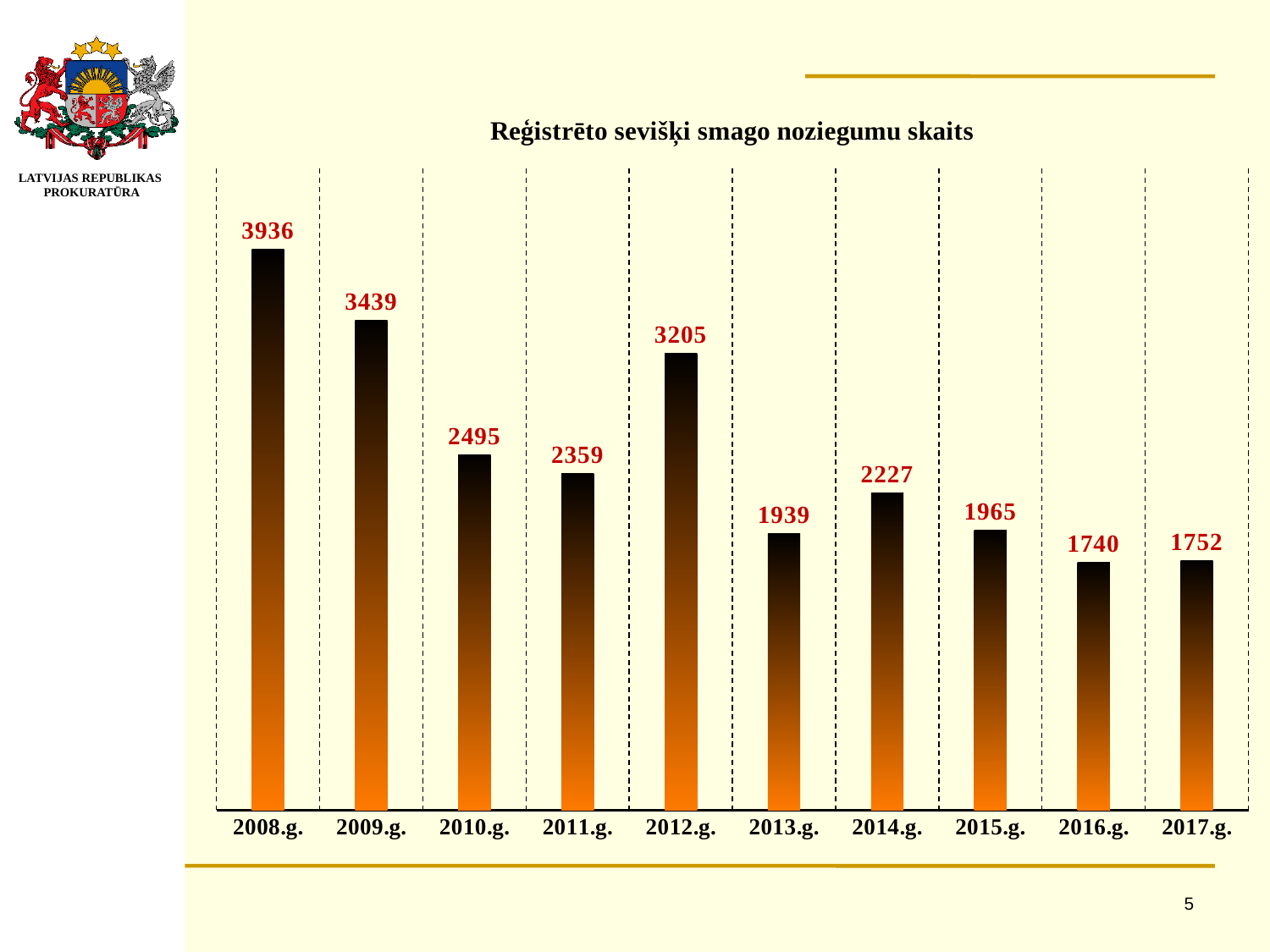
What is the value for 2017.g.? 1752 What kind of chart is shown on the slide? Bar chart What is the difference between the values for 2017.g. and 2016.g.? 12 What is the value for 2008.g.? 3936 What is the difference between the values for 2008.g. and 2009.g.? 497 Which is larger, the value for 2013.g. or the value for 2014.g.? 2014.g. What is the value for 2012.g.? 3205 Which is larger, the value for 2010.g. or the value for 2011.g.? 2010.g. Which year has the highest value? 2008.g. Which year has the lowest value? 2016.g. How many years are shown on the x axis? 10 What is the title of the chart? Reģistrēto sevišķi smago noziegumu skaits